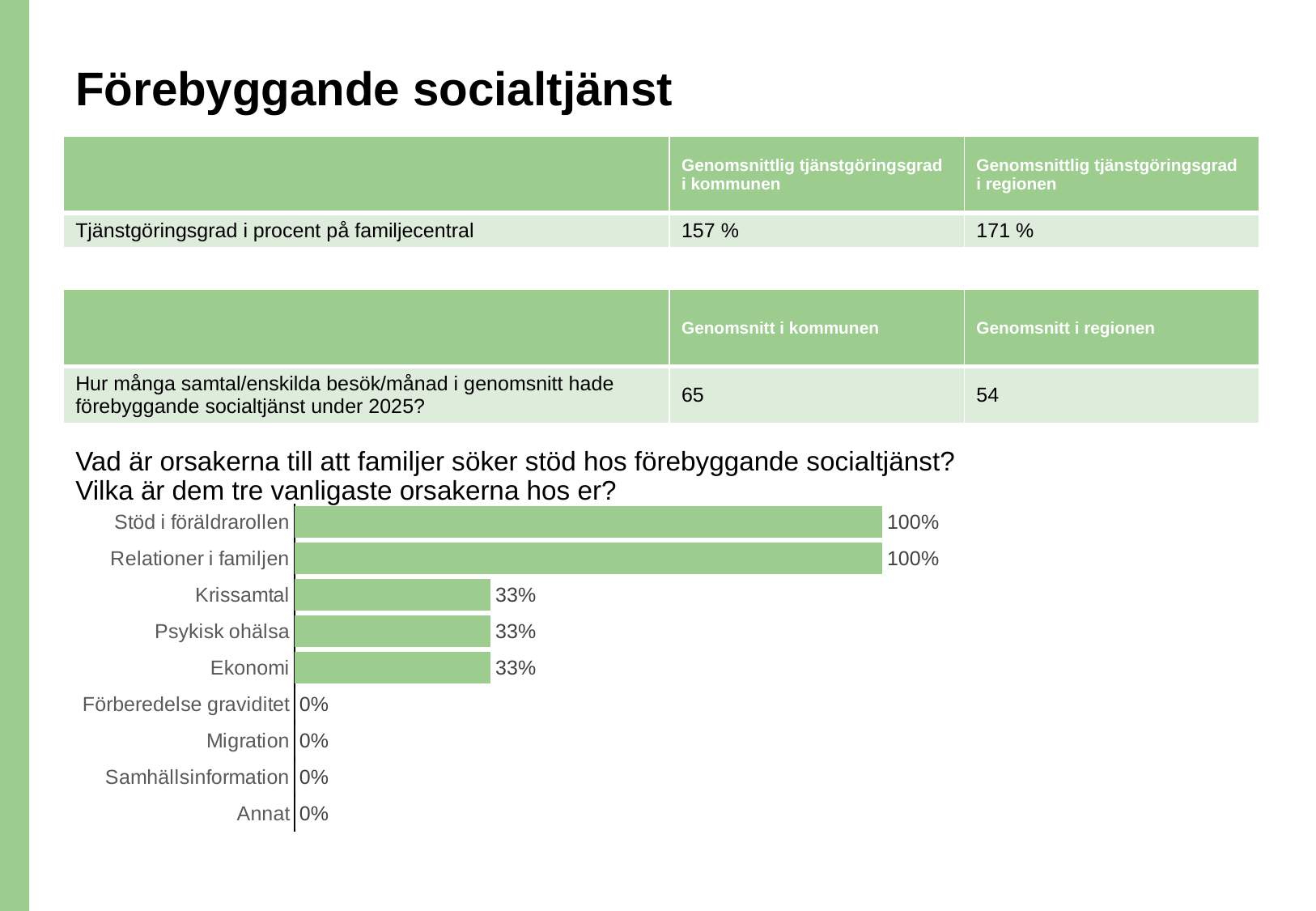
What is the value for Stöd i föräldrarollen? 100% Which is larger, the value for Ekonomi or the value for Annat? Ekonomi What is the value for Relationer i familjen? 100% What colour are the bars in the chart? green What is the value for Migration? 0% How many categories in the chart have a value of 0%? 4 What is the value for Ekonomi? 33% What is the difference between the values for Krissamtal and Samhällsinformation? 33% How many categories does the chart show? 9 What is the value for Krissamtal? 33% What is the difference between the values for Relationer i familjen and Psykisk ohälsa? 67% What kind of chart is shown on the slide? bar chart